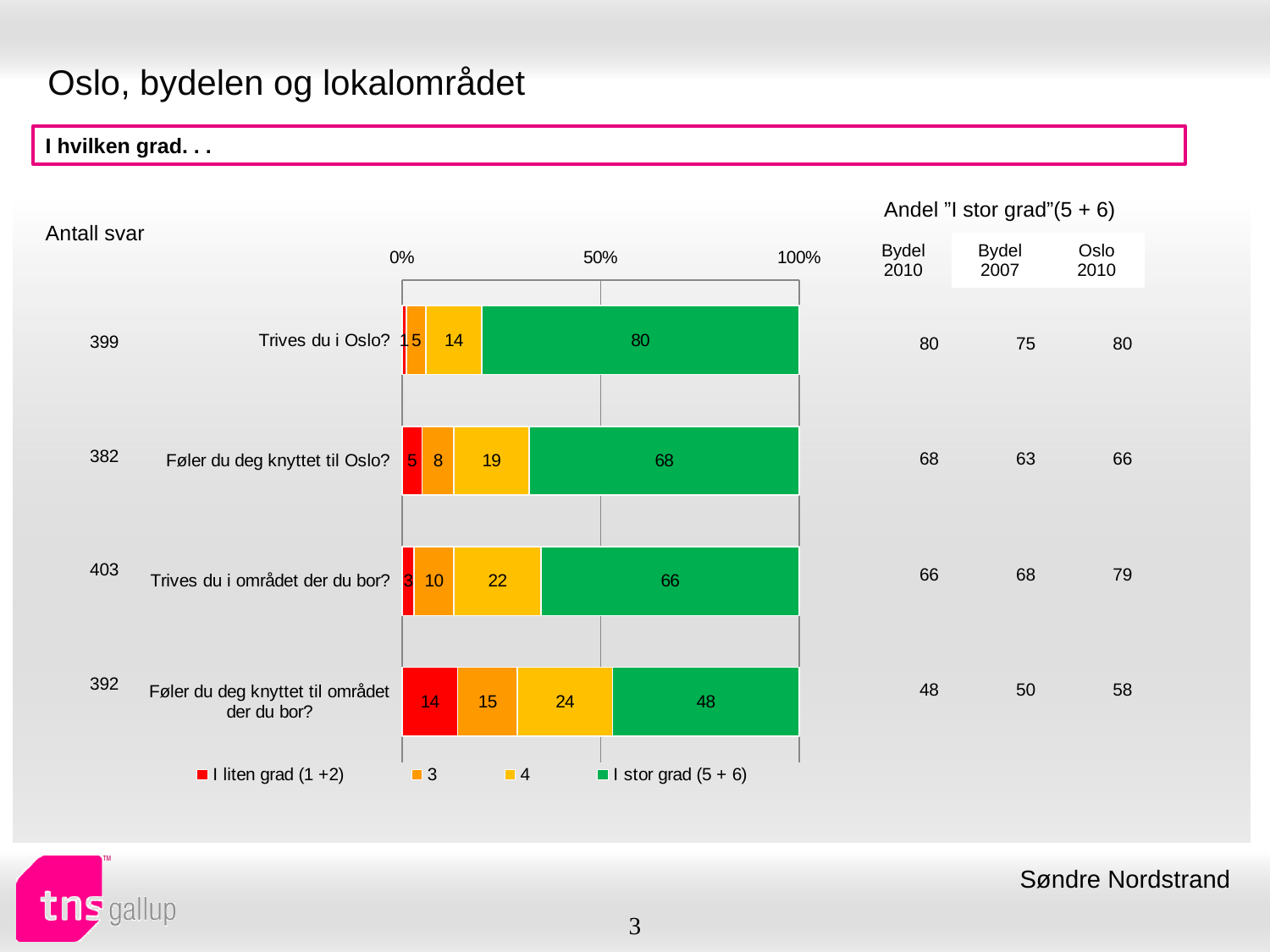
What kind of chart is shown on the slide? stacked bar chart What is the value of "I stor grad (5 + 6)" for "Trives du i Oslo?"? 80 What is the value of "I liten grad (1 +2)" for "Føler du deg knyttet til området der du bor?"? 14 How many question categories are plotted in the chart? 4 Which is larger: the "4" value for "Trives du i Oslo?" or the "4" value for "Føler du deg knyttet til Oslo?"? Føler du deg knyttet til Oslo? What is the value of series "4" for "Trives du i området der du bor?"? 22 Which category has the lowest "I stor grad (5 + 6)" value? Føler du deg knyttet til området der du bor? What is the "Antall svar" (number of responses) shown for "Trives du i området der du bor?"? 403 Which category has the highest "I stor grad (5 + 6)" value? Trives du i Oslo? What is the difference between the "I stor grad (5 + 6)" values for "Føler du deg knyttet til Oslo?" and "Føler du deg knyttet til området der du bor?"? 20 What is the value of series "3" for "Føler du deg knyttet til Oslo?"? 8 How many series does the legend list? 4